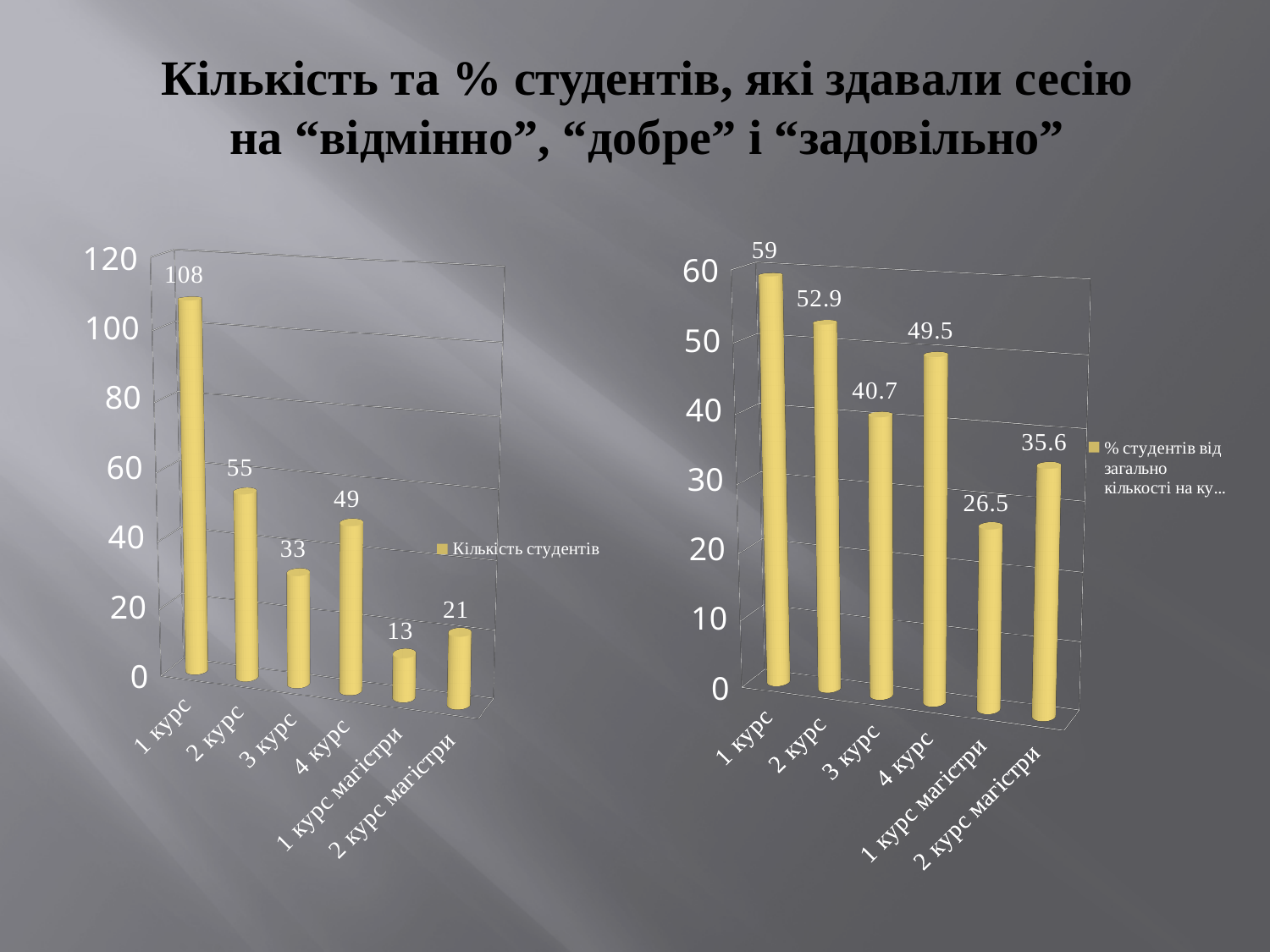
In the left chart (Кількість студентів), what is the value for 1 курс? 108 In the left chart (Кількість студентів), what is the difference between the values for 2 курс and 3 курс? 22 In the right chart (% студентів), what is the value for 2 курс? 52.9 In the left chart (Кількість студентів), how many categories are shown? 6 What type of chart is the right chart? Bar chart In the right chart (% студентів), what is the value for 2 курс магістри? 35.6 What is the legend entry of the left chart? Кількість студентів In the right chart (% студентів), which category has the highest value? 1 курс In the left chart (Кількість студентів), what is the value for 1 курс магістри? 13 In the left chart (Кількість студентів), which category has the lowest value? 1 курс магістри In the right chart (% студентів), what is the difference between the values for 4 курс and 3 курс? 8.8 In the left chart (Кількість студентів), which is larger: the value for 3 курс or 4 курс? 4 курс